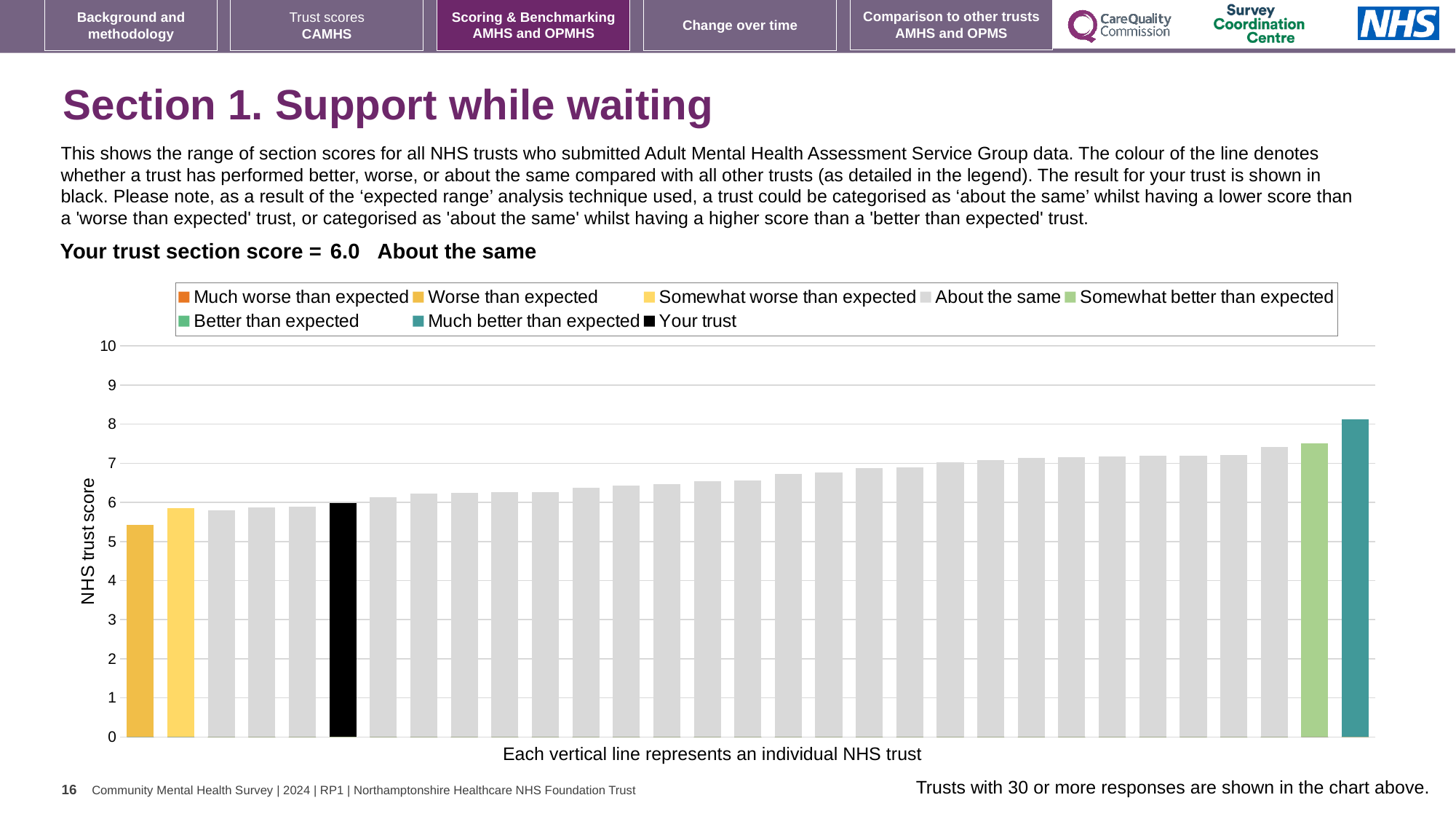
Is the value of the lowest bar in the chart greater or less than 6? less What is the highest tick value shown on the vertical axis? 10 Is the value of the highest bar in the chart greater or less than 9? less Do the bar values rise or fall from left to right across the chart? rise Which legend category does the highest bar in the chart belong to? Much better than expected What is the section score for your trust shown on the slide? 6.0 Is the value of the black 'Your trust' bar greater or less than 5? greater What kind of chart is shown on the slide? Bar chart What is the label on the vertical axis of the chart? NHS trust score Which category is your trust's section score placed in? About the same How many entries does the chart legend list? 8 Is the 'Much better than expected' bar higher or lower than the 'Somewhat better than expected' bar? higher